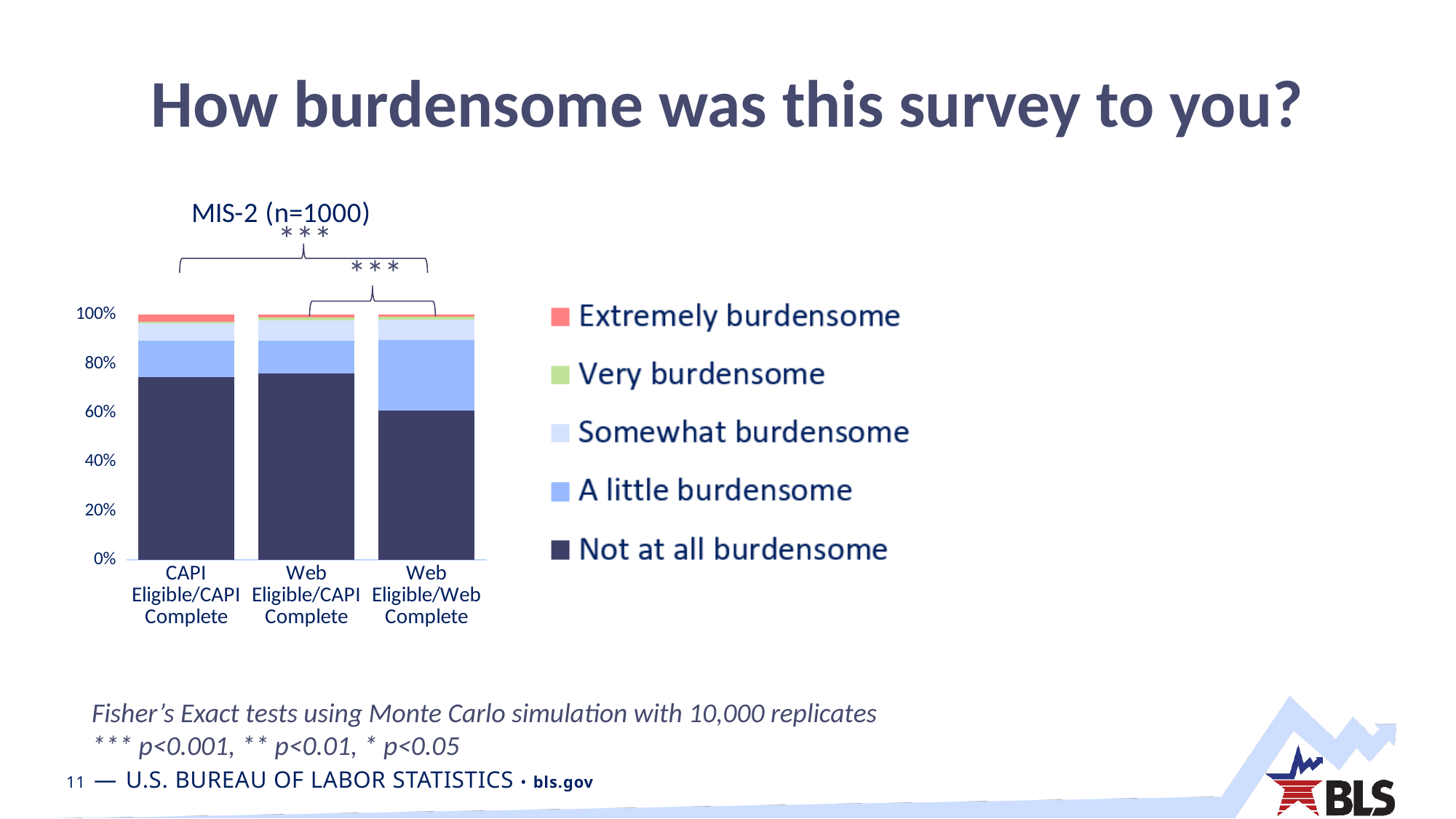
Which category has the lowest share of 'Not at all burdensome' responses? Web Eligible/Web Complete Which has a larger 'Not at all burdensome' share: CAPI Eligible/CAPI Complete or Web Eligible/Web Complete? CAPI Eligible/CAPI Complete How many categories are shown on the x axis of the chart? 3 Is the 'Not at all burdensome' share for CAPI Eligible/CAPI Complete greater or less than 60%? greater How many series does the chart's legend list? 5 What kind of chart is shown on the slide? Stacked bar chart What is the title shown above the chart? MIS-2 (n=1000) Which legend entry is listed first (at the top) in the chart's legend? Extremely burdensome Which category has the largest share of 'A little burdensome' responses? Web Eligible/Web Complete Which has a larger 'A little burdensome' share: Web Eligible/CAPI Complete or Web Eligible/Web Complete? Web Eligible/Web Complete Is the 'Not at all burdensome' share for Web Eligible/CAPI Complete greater or less than 80%? less Is the 'Not at all burdensome' share for Web Eligible/Web Complete greater or less than 80%? less